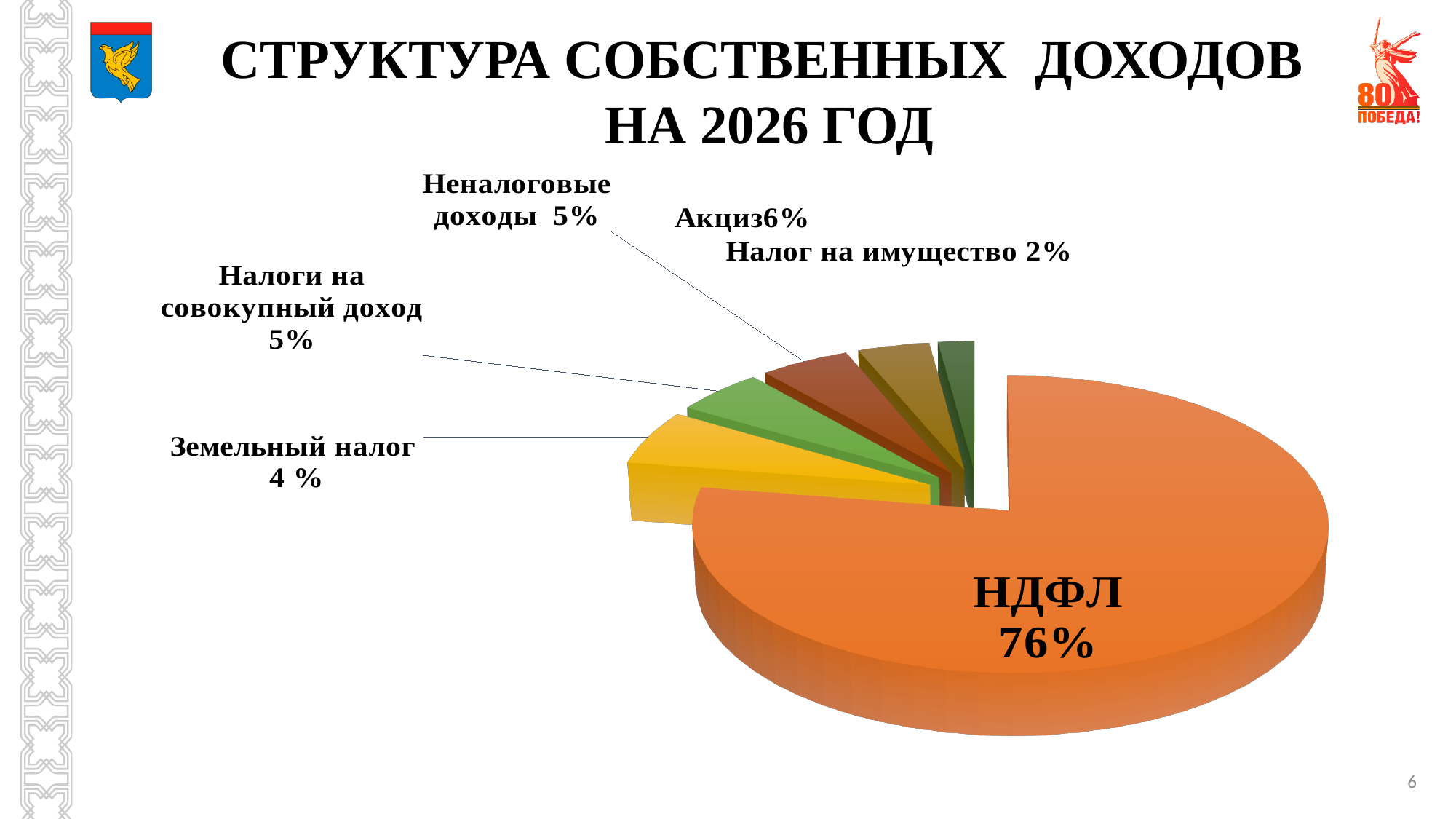
What type of chart is shown on the slide? Pie chart Which category has the largest share of the pie? НДФЛ What percentage is shown for Налоги на совокупный доход? 5% What is the value for Неналоговые доходы? 5% Which category has the smallest share of the pie? Налог на имущество What share is shown for Налог на имущество? 2% Which is larger, Акциз or Земельный налог? Акциз What is the value shown for Земельный налог? 4 % What is the value for Акциз? 6% By how many percentage points does НДФЛ exceed Акциз? 70 How many slices does the pie chart have? 6 What share of own revenues does НДФЛ account for? 76%